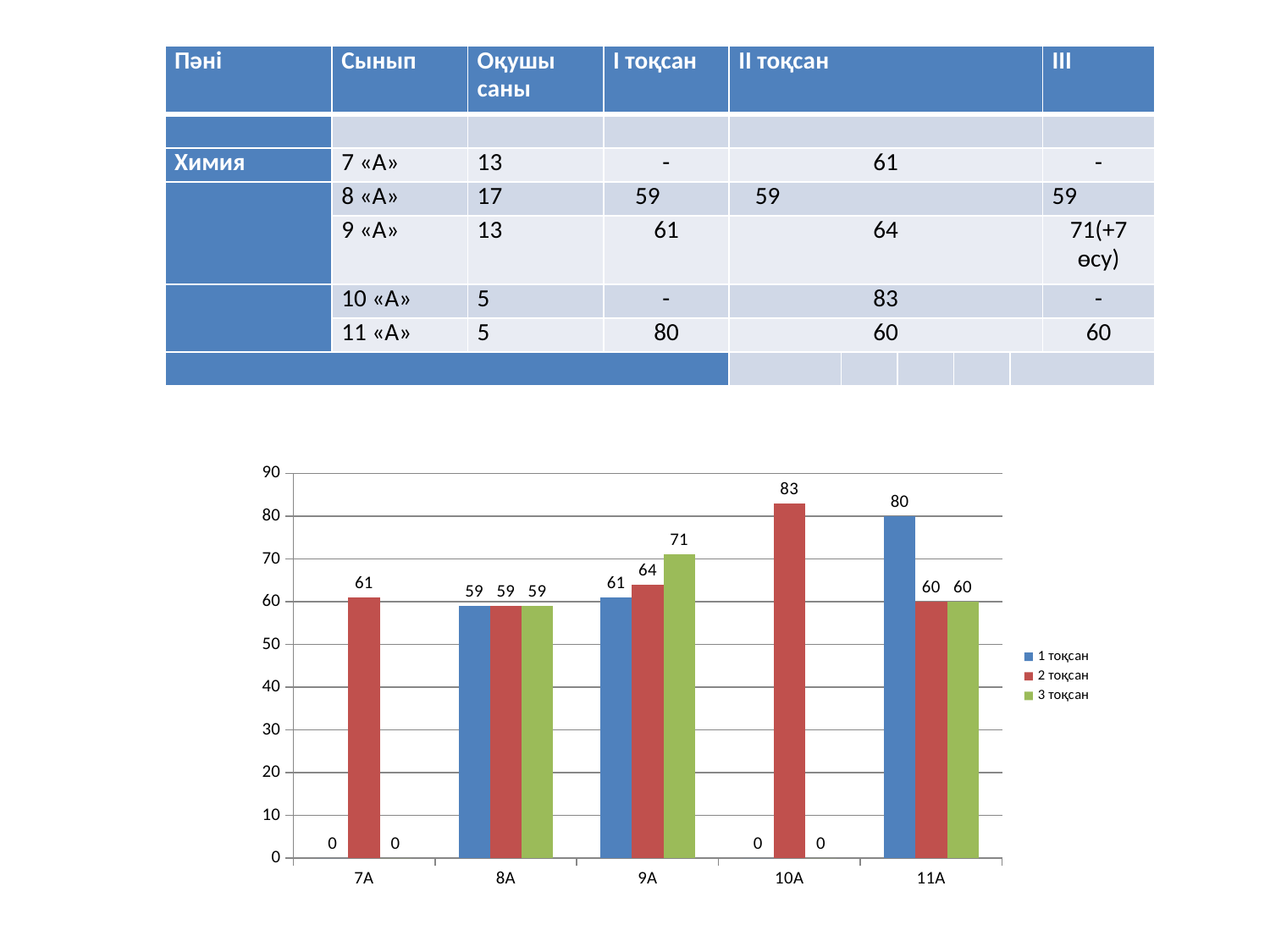
What kind of chart is shown on the slide? bar chart What is the value for 1 тоқсан for 11A? 80 How many series does the legend list? 3 Which category has the highest value for 2 тоқсан? 10A Is the value for 2 тоқсан for 10A greater or less than 80? greater What is the value for 3 тоқсан for 9A? 71 Which is larger: the 1 тоқсан value for 11A or the 2 тоқсан value for 11A? 1 тоқсан What is the difference between the 3 тоқсан value for 9A and the 3 тоқсан value for 8A? 12 How many categories are shown on the x axis? 5 Do the values for 9A rise or fall from 1 тоқсан to 3 тоқсан? rise Which category has the lowest value for 3 тоқсан among those with a non-zero bar? 8A What is the value for 2 тоқсан for 10A? 83